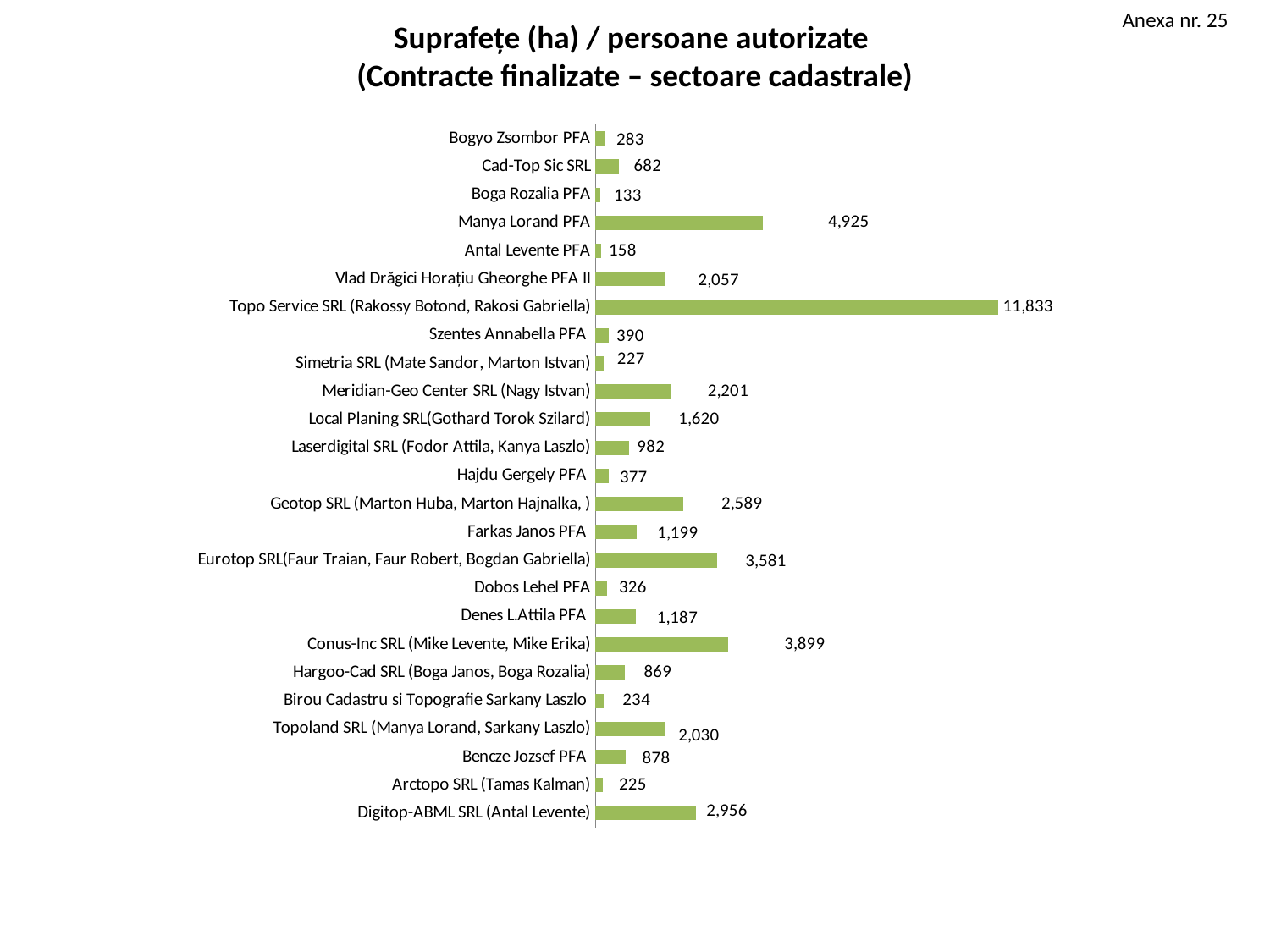
How many categories are shown in the chart? 25 Which is larger, the value for Meridian-Geo Center SRL (Nagy Istvan) or the value for Vlad Drăgici Horațiu Gheorghe PFA II? Meridian-Geo Center SRL (Nagy Istvan) What is the difference between the values for Topo Service SRL (Rakossy Botond, Rakosi Gabriella) and Manya Lorand PFA? 6,908 What is the value for Manya Lorand PFA? 4,925 Which is larger, the value for Bencze Jozsef PFA or the value for Laserdigital SRL (Fodor Attila, Kanya Laszlo)? Laserdigital SRL (Fodor Attila, Kanya Laszlo) What kind of chart is shown on the slide? Bar chart Which category has the highest value? Topo Service SRL (Rakossy Botond, Rakosi Gabriella) What is the value for Eurotop SRL(Faur Traian, Faur Robert, Bogdan Gabriella)? 3,581 What is the title of the chart? Suprafețe (ha) / persoane autorizate (Contracte finalizate – sectoare cadastrale) Which category has the lowest value? Boga Rozalia PFA What is the difference between the values for Conus-Inc SRL (Mike Levente, Mike Erika) and Geotop SRL (Marton Huba, Marton Hajnalka, )? 1,310 What is the value for Digitop-ABML SRL (Antal Levente)? 2,956